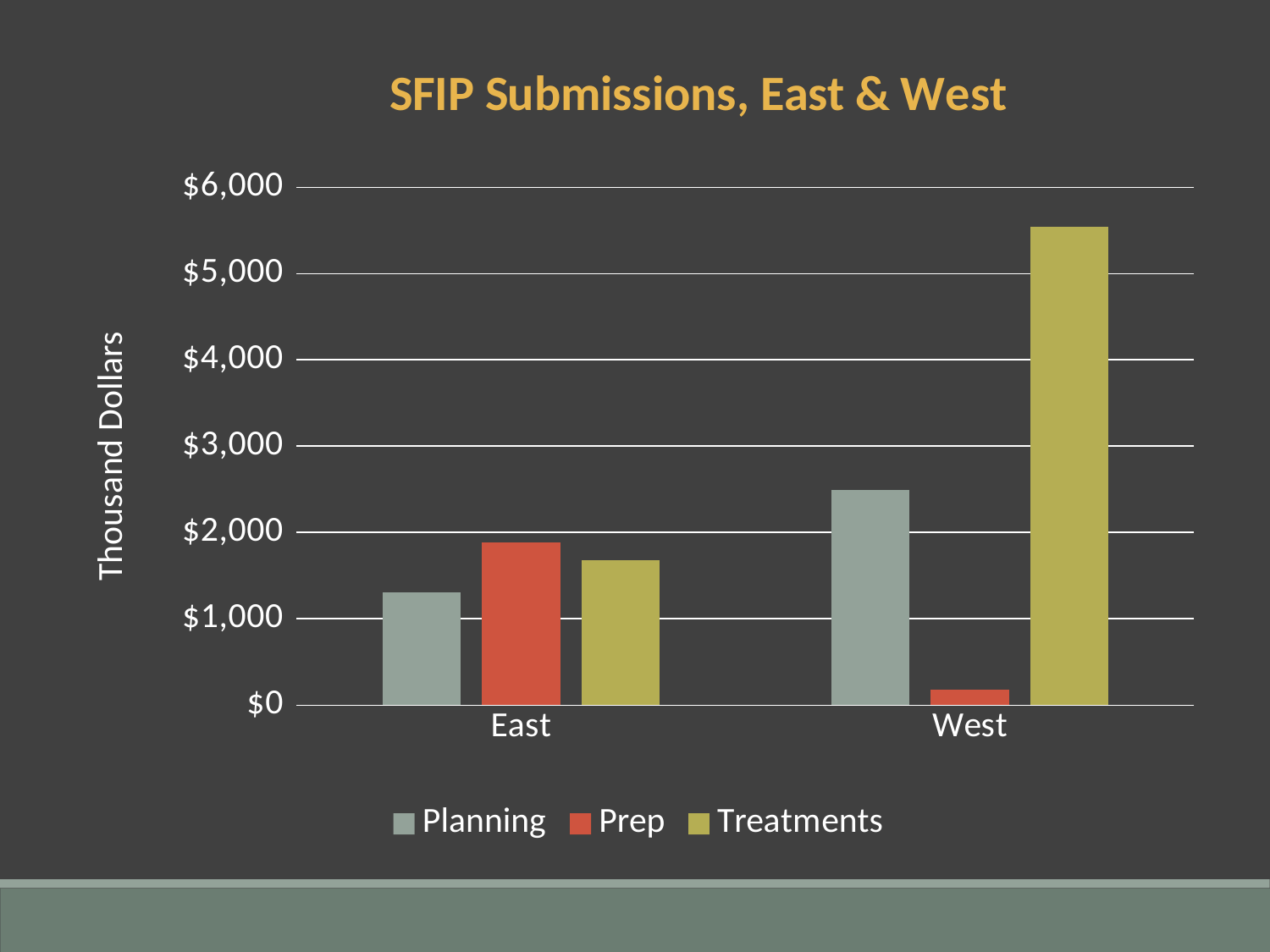
What kind of chart is shown on the slide? bar chart How many series does the legend list? 3 How many categories are shown on the x axis? 2 Which series has the lowest value for West? Prep What is the title of the chart? SFIP Submissions, East & West What is the label on the vertical axis? Thousand Dollars Which series has the highest value for West? Treatments Is the Treatments value for West greater or less than $5,000? greater Is the Prep value for West greater or less than $1,000? less Is the Planning value for East greater or less than $2,000? less Which is larger, the Planning value for East or the Planning value for West? West Which series has the lowest value for East? Planning